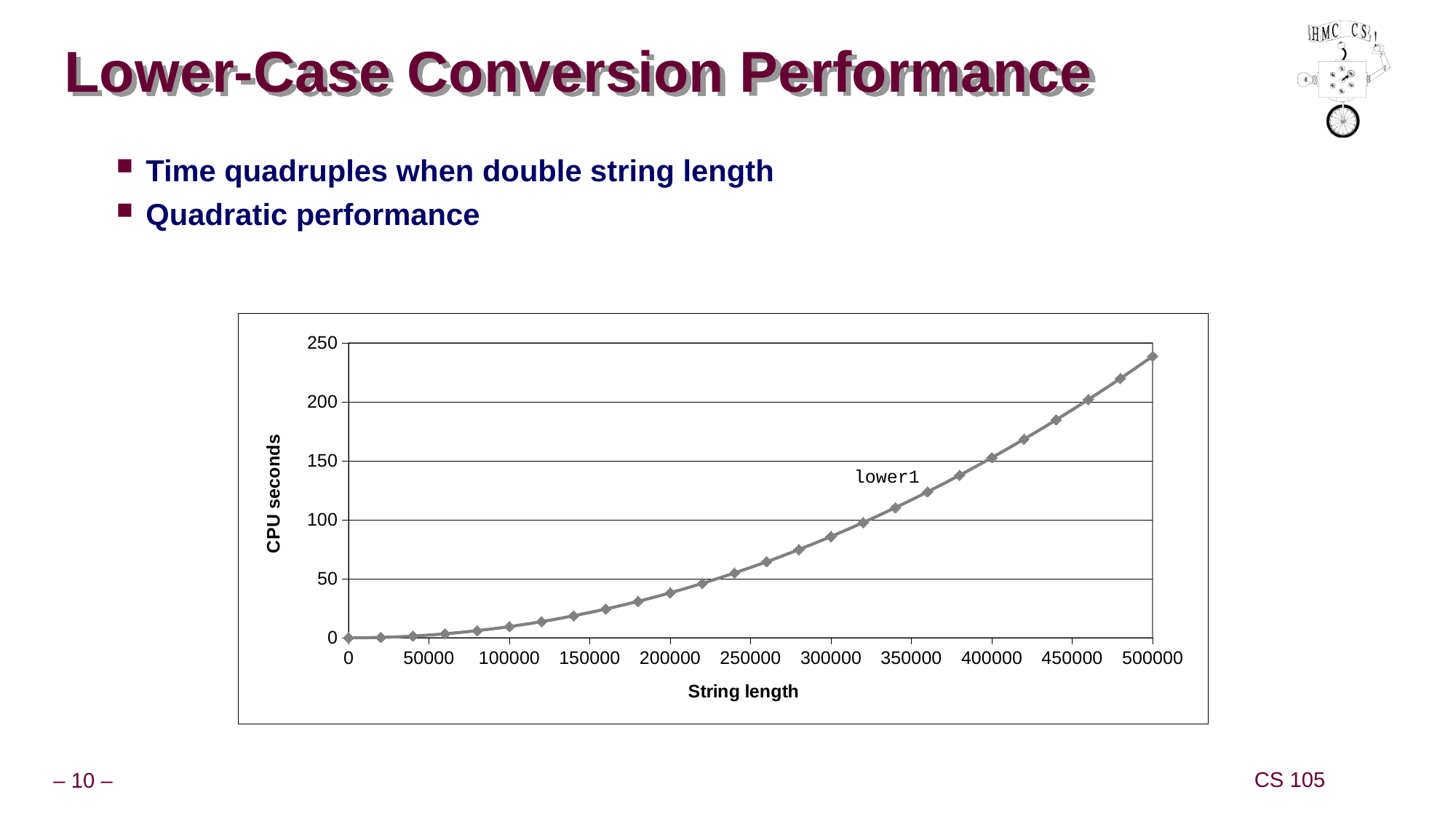
How many data series are plotted in the chart? 1 What is the label of the x axis? String length What is the label of the y axis? CPU seconds At which string length is the CPU time lowest? 0 Is the CPU seconds value at string length 100000 greater or less than 50? less At which string length is the CPU time highest? 500000 What kind of chart is shown on the slide? line chart Is the CPU seconds value at string length 400000 greater or less than 100? greater What is the name of the series plotted in the chart? lower1 Which has a larger CPU seconds value: string length 200000 or string length 300000? 300000 Do the CPU seconds rise or fall as string length increases? rise Is the CPU seconds value at string length 500000 greater or less than 200? greater